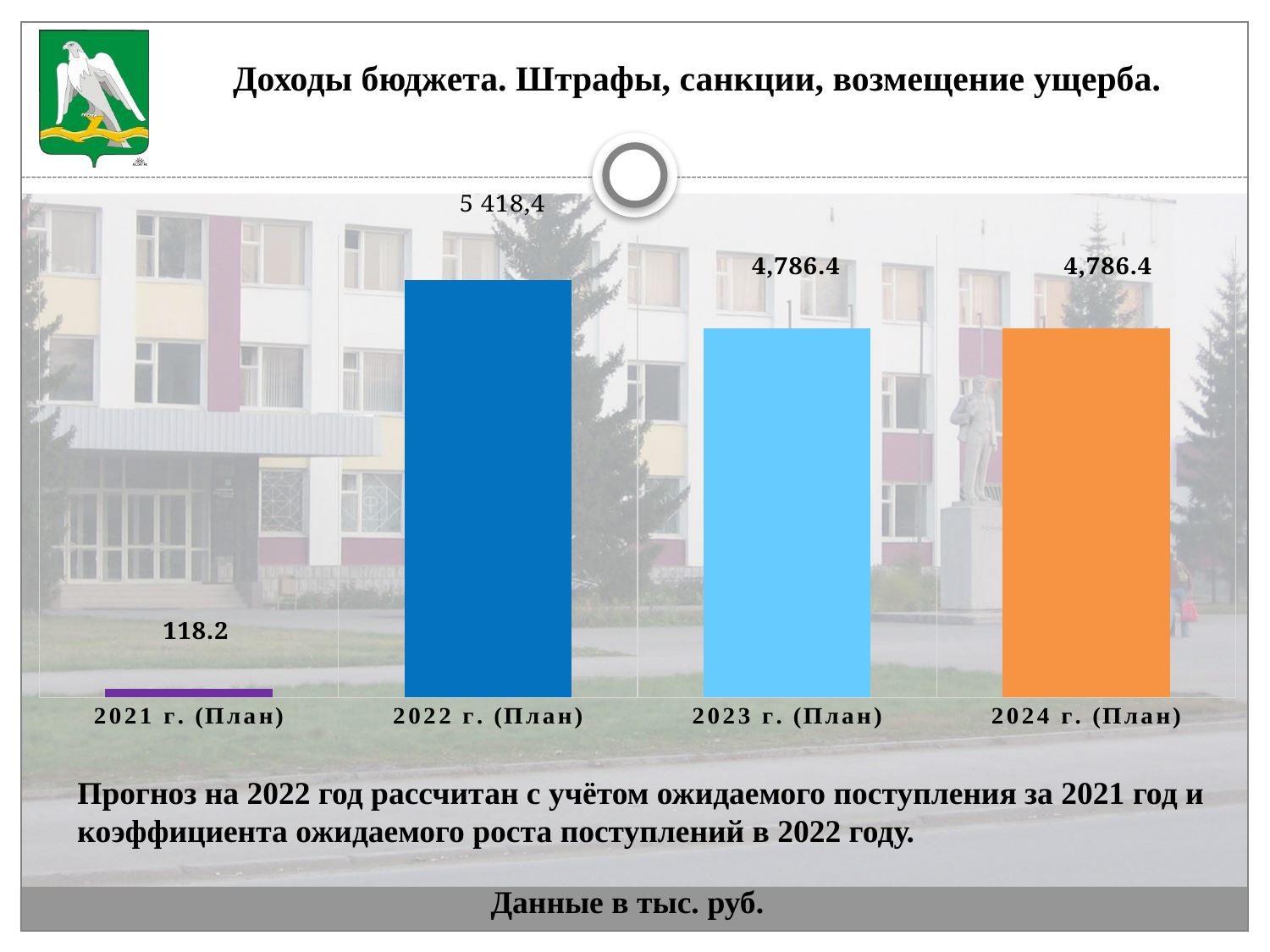
What is the value for 2022 г. (План)? 5 418,4 What kind of chart is shown on the slide? bar chart What is the value for 2021 г. (План)? 118.2 What is the value for 2023 г. (План)? 4,786.4 How many categories are shown on the chart? 4 Does the value rise or fall from 2021 г. (План) to 2022 г. (План)? rise Which category has the highest value? 2022 г. (План) What is the title of the chart? Доходы бюджета. Штрафы, санкции, возмещение ущерба. What is the value for 2024 г. (План)? 4,786.4 What is the difference between the values for 2023 г. (План) and 2021 г. (План)? 4,668.2 Which is larger, the value for 2022 г. (План) or the value for 2023 г. (План)? 2022 г. (План) Which category has the lowest value? 2021 г. (План)